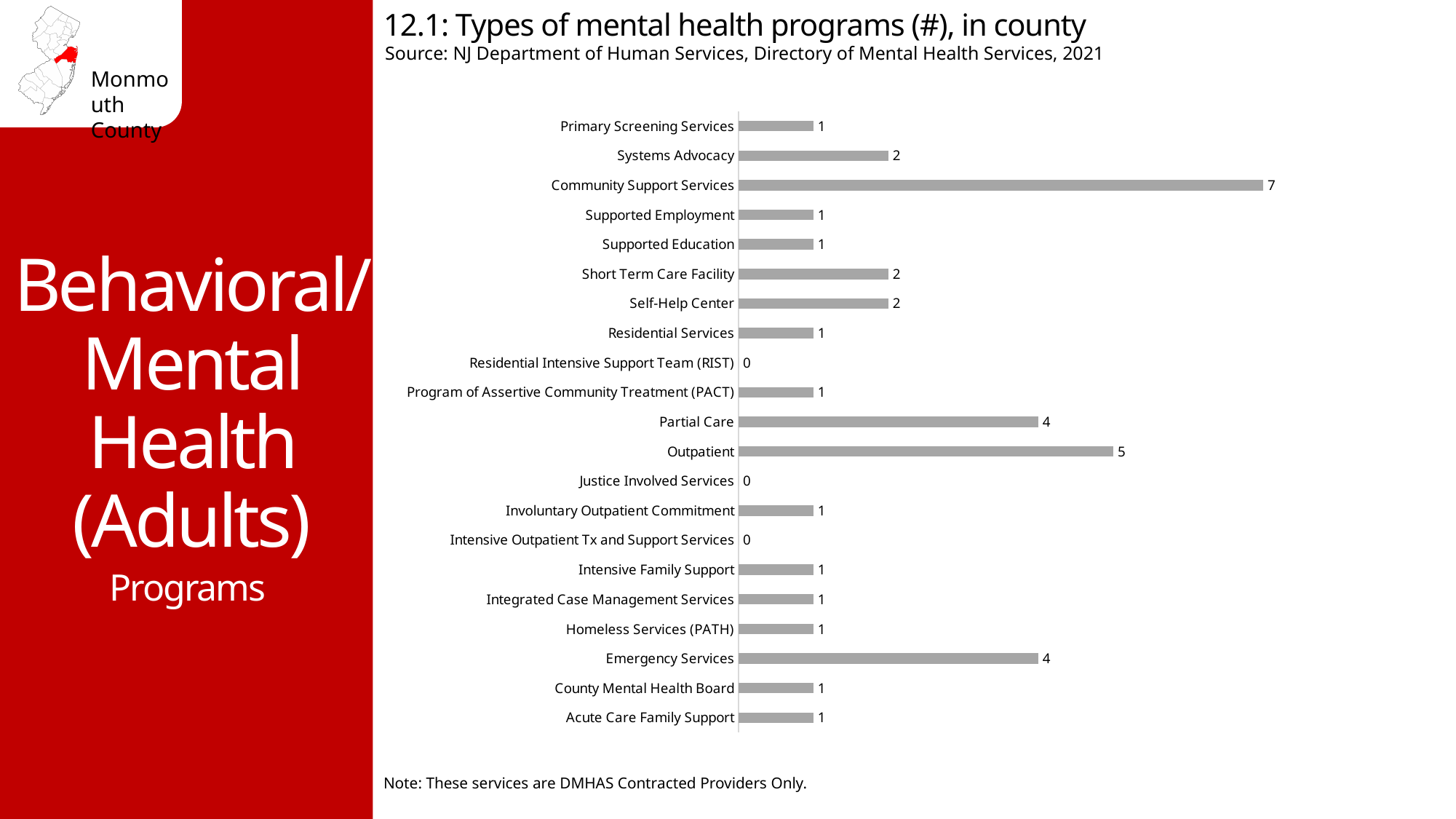
How many program types are listed in the chart? 21 How many program types have a value of 0? 3 What is the value for Outpatient programs? 5 What is the title of the chart? 12.1: Types of mental health programs (#), in county What is the source cited for the chart data? NJ Department of Human Services, Directory of Mental Health Services, 2021 Which has more programs, Emergency Services or Self-Help Center? Emergency Services How many Partial Care programs are shown? 4 What is the value for Residential Intensive Support Team (RIST)? 0 How many Community Support Services programs are shown in the chart? 7 What is the difference between the number of Community Support Services programs and Outpatient programs? 2 What kind of chart is shown on the slide? Bar chart Which type of mental health program has the highest count? Community Support Services